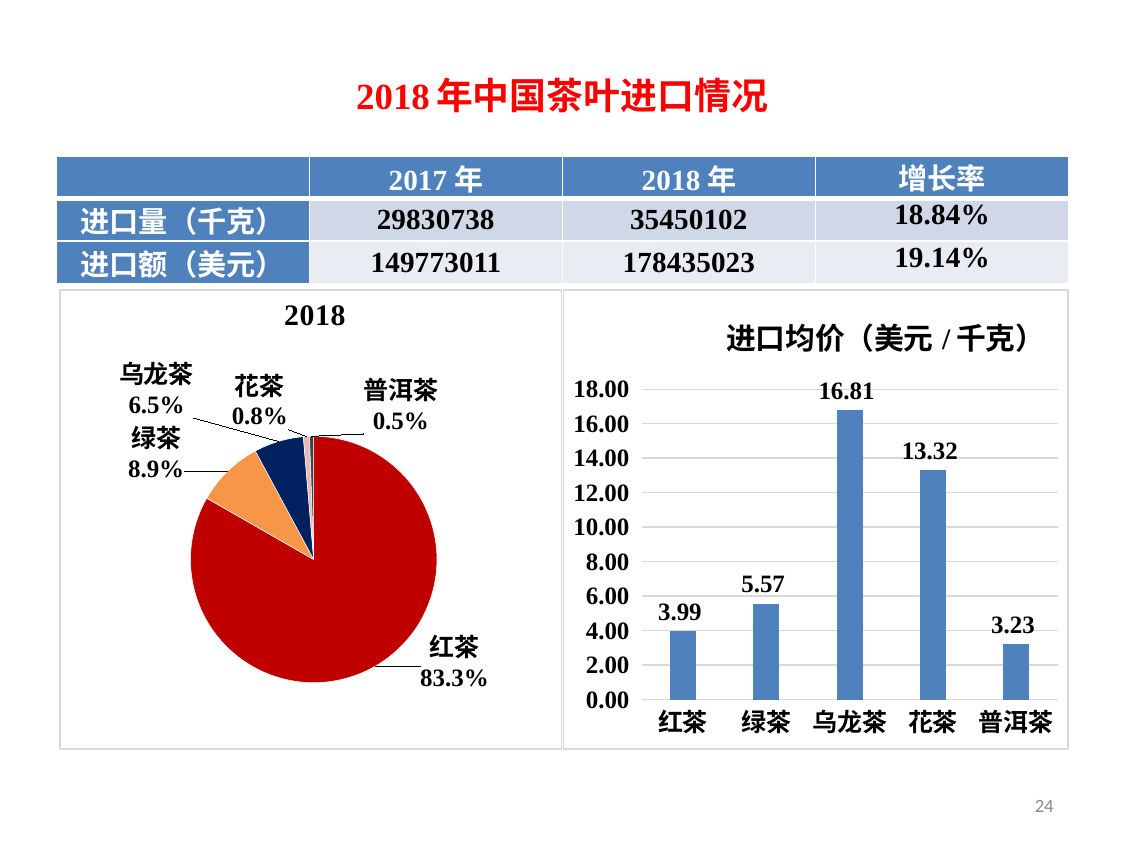
In the pie chart titled 2018, what share does 绿茶 have? 8.9% In the bar chart titled 进口均价（美元/千克）, what is the difference between 乌龙茶 and 花茶? 3.49 In the bar chart titled 进口均价（美元/千克）, which category has the lowest value? 普洱茶 In the pie chart titled 2018, how many slices are there? 5 In the bar chart titled 进口均价（美元/千克）, which category has the highest value? 乌龙茶 What kind of chart is the chart on the right of the slide? bar chart In the pie chart titled 2018, which category has the smallest slice? 普洱茶 In the bar chart titled 进口均价（美元/千克）, what is the value for 乌龙茶? 16.81 In the bar chart titled 进口均价（美元/千克）, what is the value for 普洱茶? 3.23 In the bar chart titled 进口均价（美元/千克）, which is larger, 红茶 or 绿茶? 绿茶 In the pie chart titled 2018, what share does 红茶 have? 83.3% In the pie chart titled 2018, what is the difference between the shares of 乌龙茶 and 花茶? 5.7%